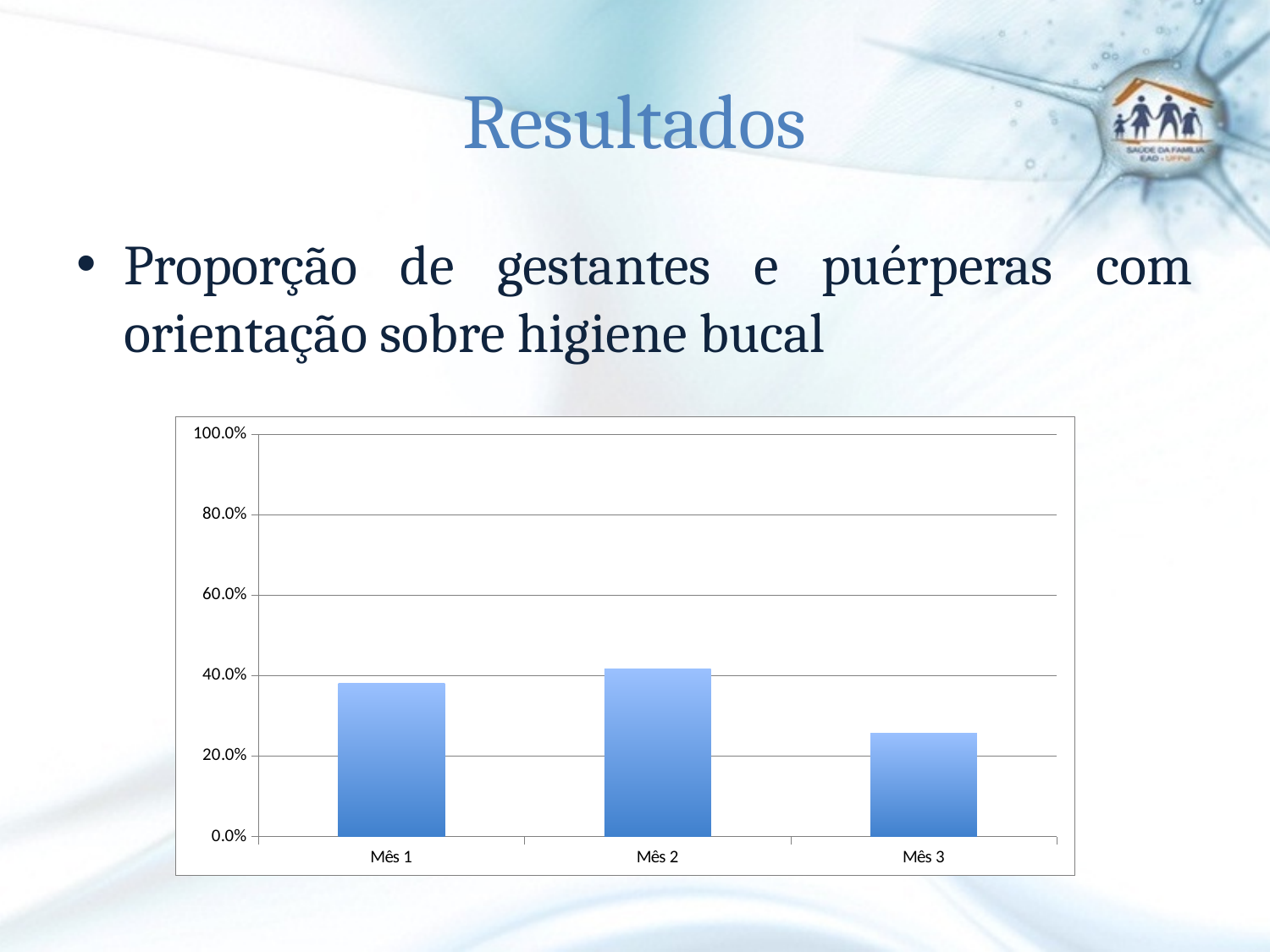
Is the value for Mês 3 greater or less than 40.0%? less What is the label of the first category on the horizontal axis? Mês 1 Is the value for Mês 3 greater or less than 20.0%? greater Is the value for Mês 2 greater or less than 40.0%? greater What is the highest value shown on the vertical axis of the chart? 100.0% Which month has the lowest proportion on the chart? Mês 3 Which is larger, the value for Mês 2 or the value for Mês 3? Mês 2 What kind of chart is shown on the slide? bar chart How many categories (months) are plotted on the chart? 3 Which month has the highest proportion on the chart? Mês 2 Which is larger, the value for Mês 1 or the value for Mês 3? Mês 1